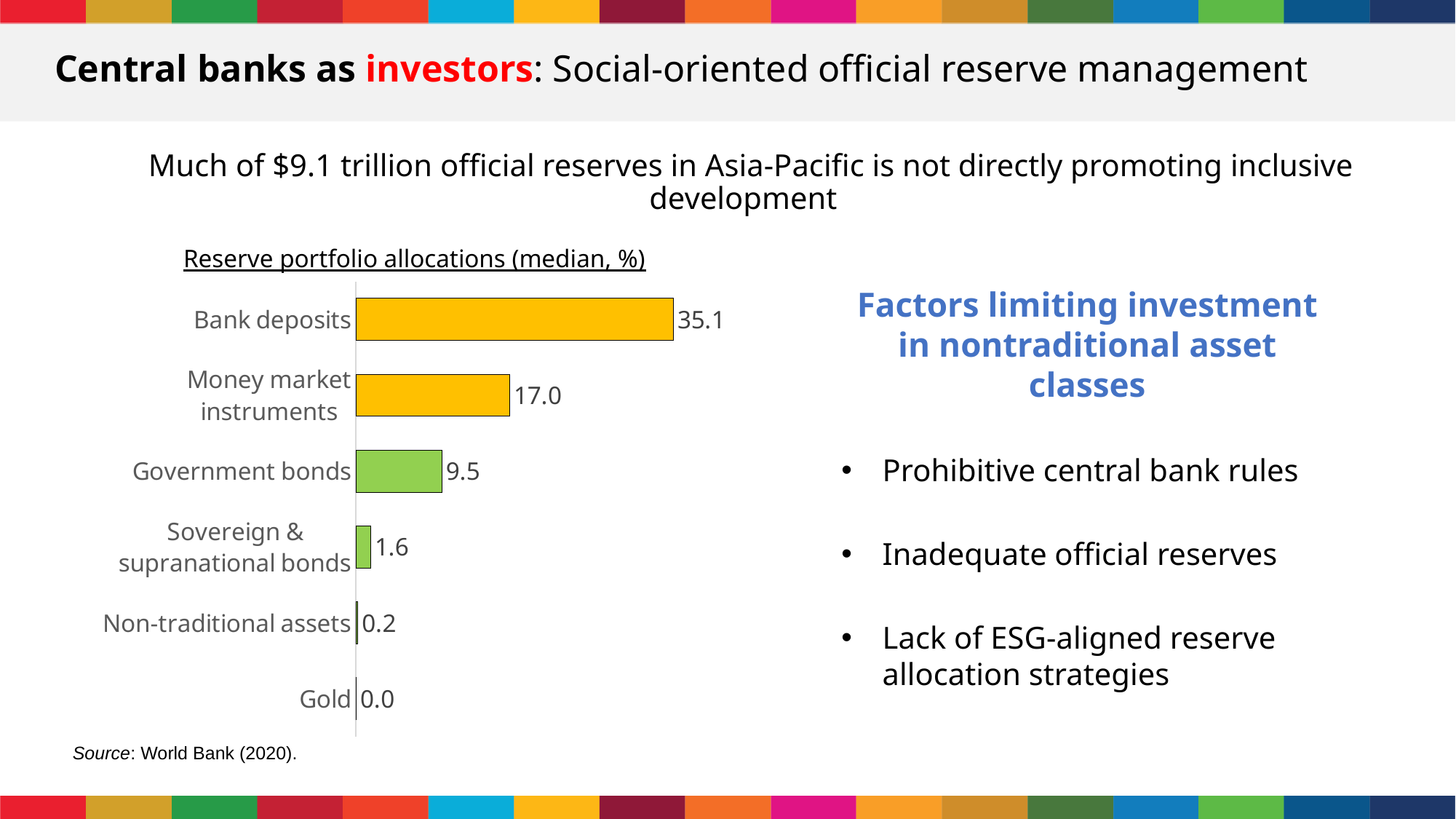
What is the median reserve portfolio allocation for Bank deposits? 35.1 What is the difference between the values for Bank deposits and Money market instruments? 18.1 What is the value shown for Government bonds? 9.5 What kind of chart is shown on the slide? Bar chart How many categories are shown in the chart? 6 Which category has the lowest median allocation? Gold Which category has the highest median allocation? Bank deposits What is the value shown for Money market instruments? 17.0 What is the value shown for Non-traditional assets? 0.2 What is the title of the chart? Reserve portfolio allocations (median, %) Which is larger, the value for Government bonds or the value for Sovereign & supranational bonds? Government bonds What is the value shown for Sovereign & supranational bonds? 1.6